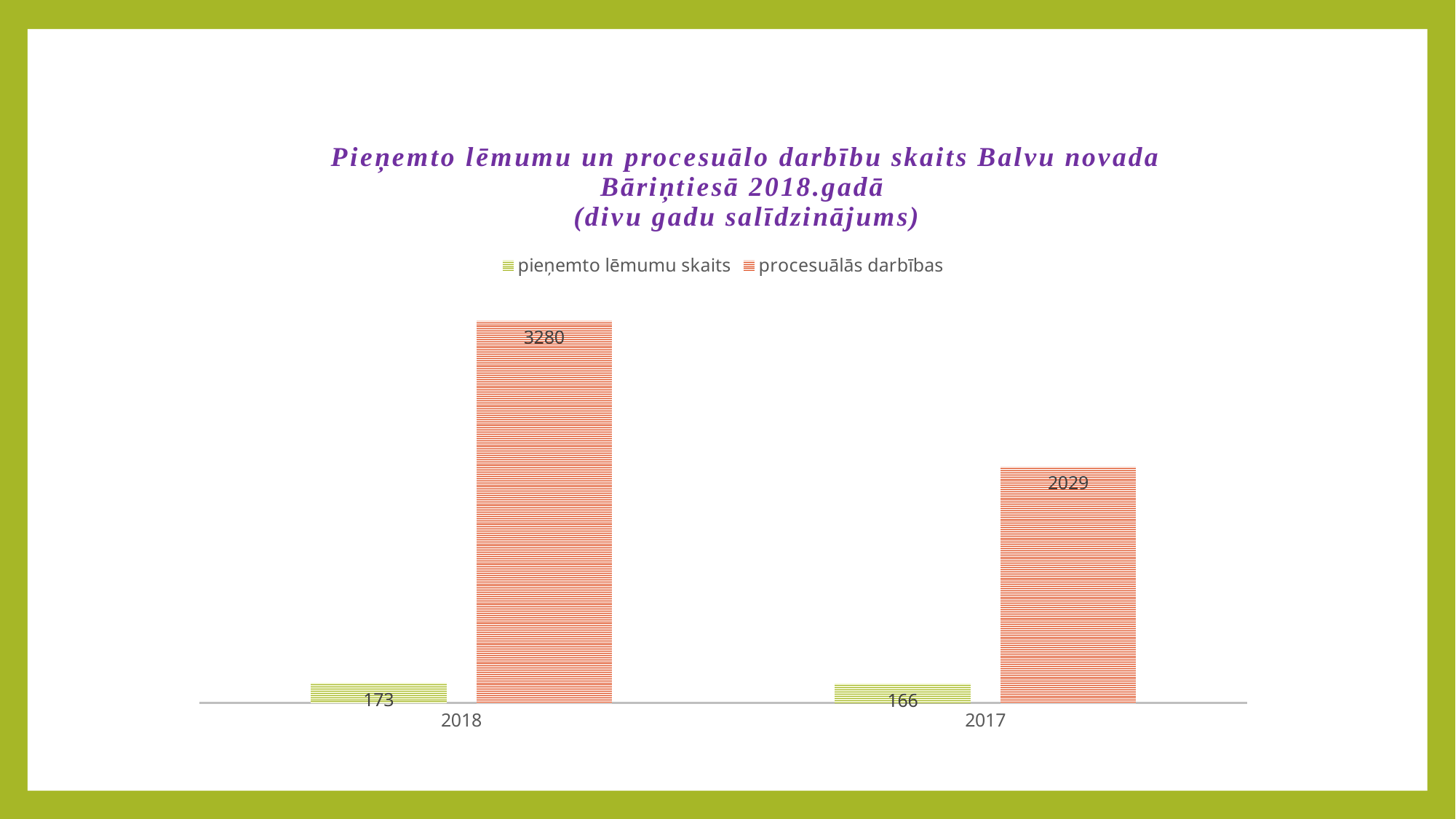
Which year has the higher value for 'procesuālās darbības'? 2018 How many series does the legend list? 2 Which year has the lower value for 'pieņemto lēmumu skaits'? 2017 What is the difference between 'pieņemto lēmumu skaits' in 2018 and 2017? 7 What kind of chart is shown on the slide? Bar chart What is the value of 'pieņemto lēmumu skaits' for 2018? 173 Is 'procesuālās darbības' larger in 2018 or in 2017? 2018 How many years are shown on the x axis? 2 What is the difference between 'procesuālās darbības' in 2018 and 2017? 1251 What is the value of 'pieņemto lēmumu skaits' for 2017? 166 What is the value of 'procesuālās darbības' for 2018? 3280 What is the value of 'procesuālās darbības' for 2017? 2029